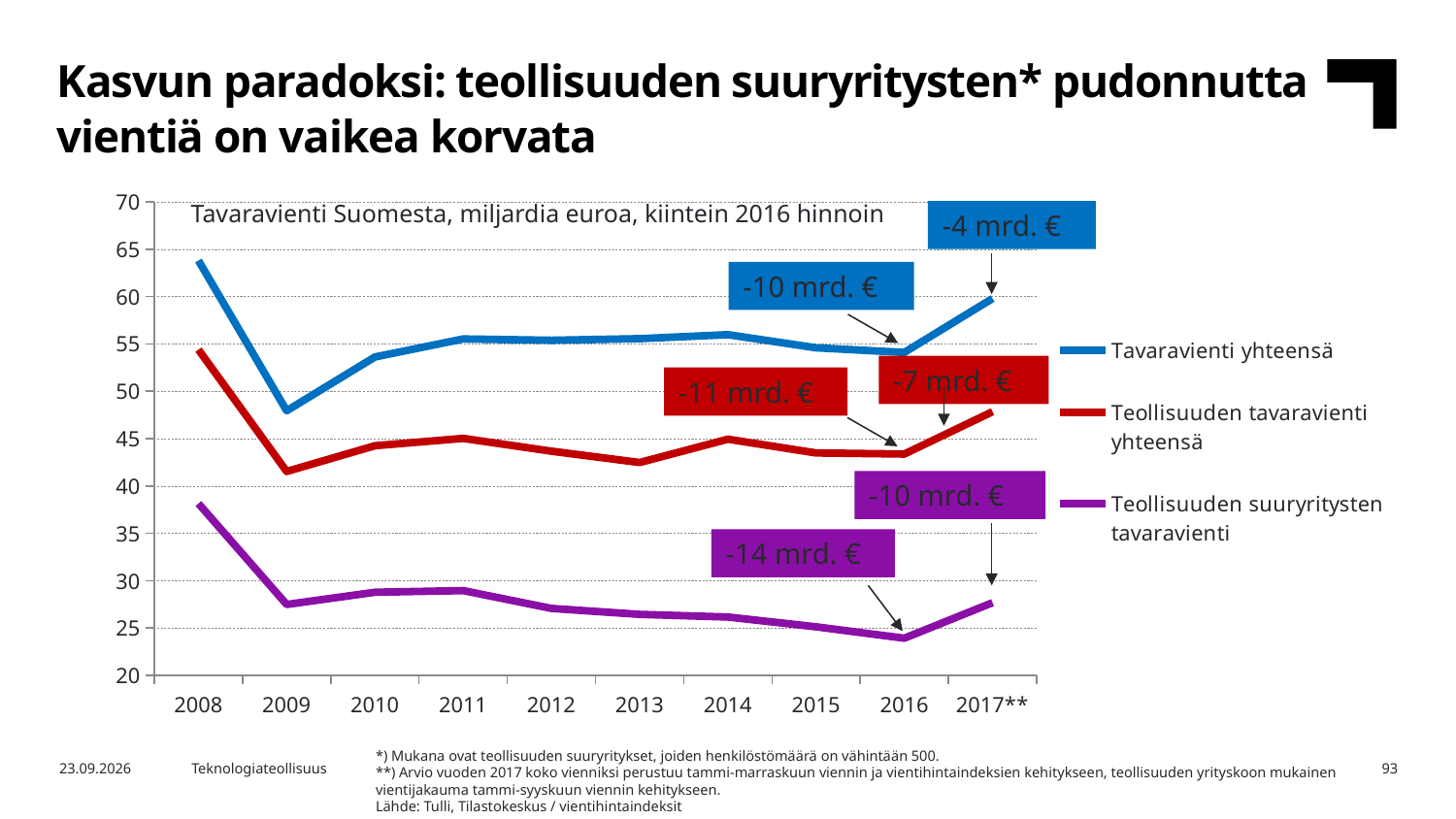
Is the value for Teollisuuden tavaravienti yhteensä in 2009 greater or less than 45? less What kind of chart is shown on the slide? Line chart What is the title printed inside the chart area? Tavaravienti Suomesta, miljardia euroa, kiintein 2016 hinnoin How many series does the legend list? 3 Which year has the highest value for Tavaravienti yhteensä? 2008 Is the value for Teollisuuden suuryritysten tavaravienti in 2016 greater or less than 25? less Does Teollisuuden suuryritysten tavaravienti rise or fall from 2011 to 2016? Fall Is the value for Tavaravienti yhteensä in 2008 greater or less than 60? greater How many years are shown on the x axis? 10 Which year has the lowest value for Tavaravienti yhteensä? 2009 Which is larger for Teollisuuden suuryritysten tavaravienti: the value in 2008 or in 2017**? 2008 Which year has the lowest value for Teollisuuden suuryritysten tavaravienti? 2016